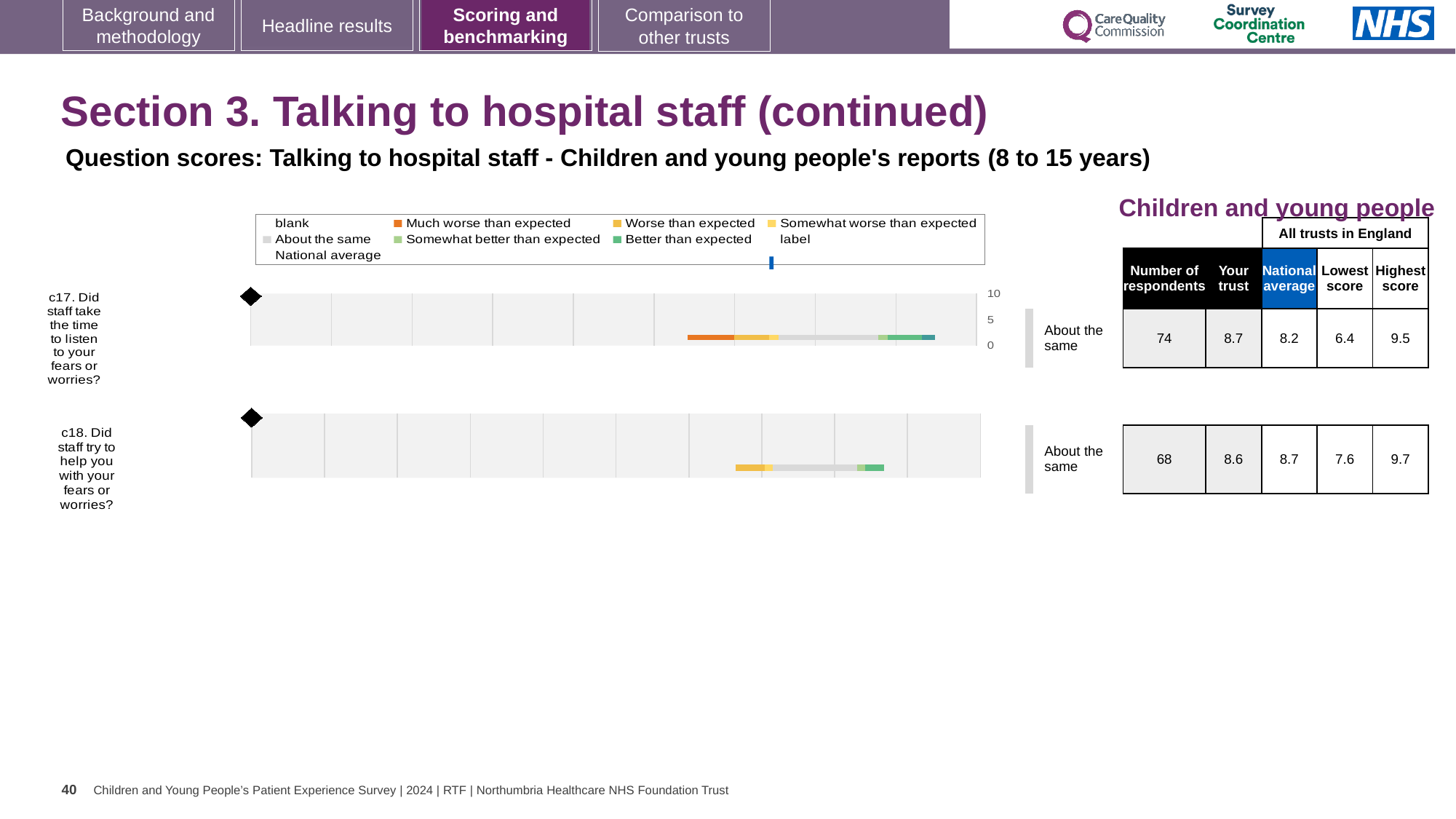
For question c18, which is larger: the 'Your trust' score or the national average? National average How many respondents answered question c17? 74 What is the difference in the number of respondents between question c17 and question c18? 6 For question c17, what is the difference between the highest score and the lowest score across all trusts in England? 3.1 What is the lowest score across all trusts in England for question c18? 7.6 What benchmark category is shown next to the chart for question c17? About the same Which question has the higher 'Your trust' score, c17 or c18? c17 What is the national average score for question c18 (Did staff try to help you with your fears or worries?)? 8.7 What is the highest score across all trusts in England for question c17? 9.5 How many survey questions are plotted on this slide? 2 What kind of chart is used to show the question scores on this slide? Bar chart What is the 'Your trust' score for question c17 (Did staff take the time to listen to your fears or worries?)? 8.7